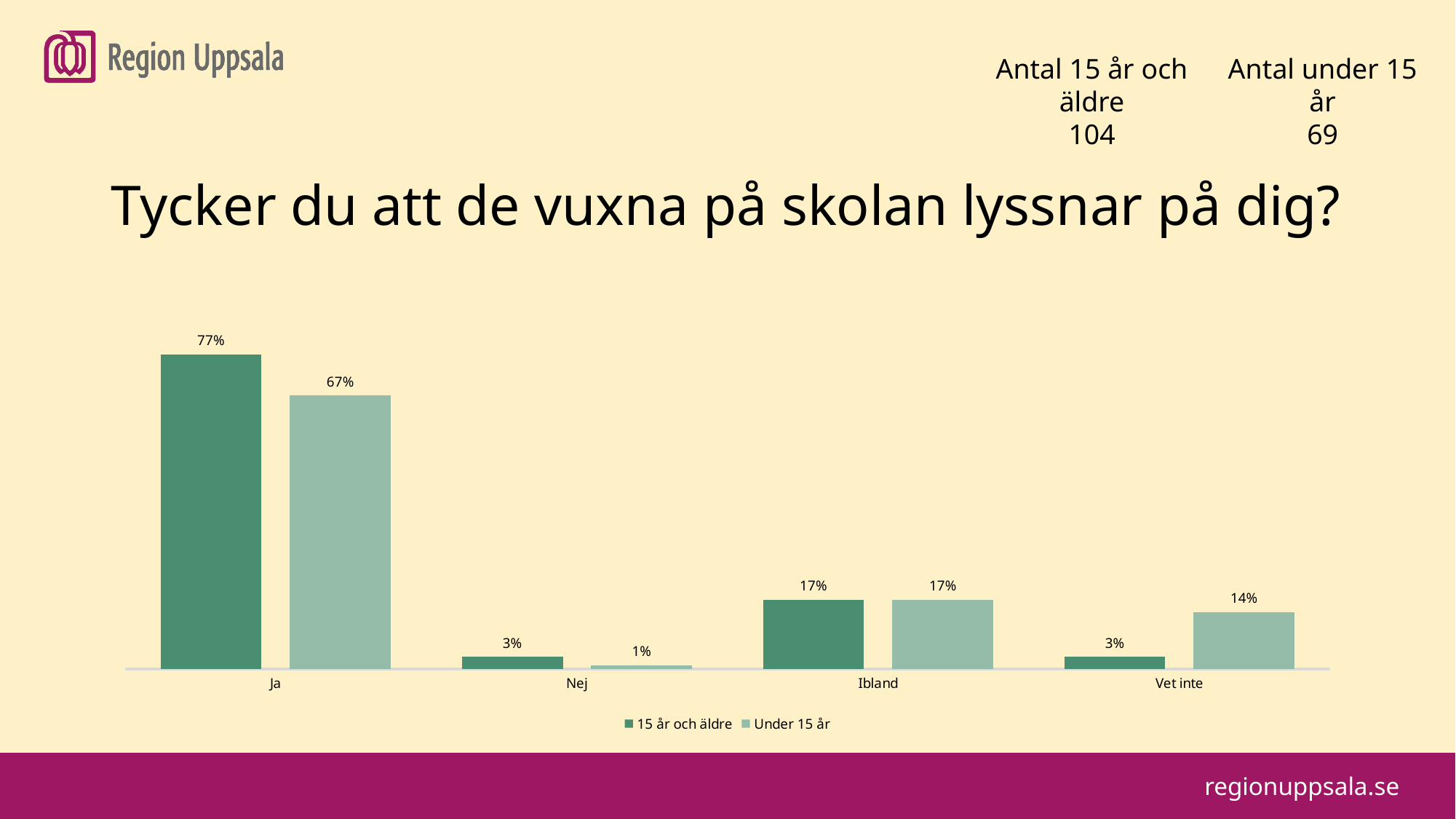
What is the title of the slide above the chart? Tycker du att de vuxna på skolan lyssnar på dig? What is the difference between the "15 år och äldre" and "Under 15 år" values in the "Ja" category? 10 percentage points What is the value for "15 år och äldre" in the "Ja" category? 77% How many categories are shown on the x axis? 4 What is the value for "Under 15 år" in the "Vet inte" category? 14% Which category has the highest value for the "15 år och äldre" series? Ja What is the value for "Under 15 år" in the "Ja" category? 67% In the "Vet inte" category, which series has the larger value? Under 15 år What is the value for "15 år och äldre" in the "Nej" category? 3% Which category has the lowest value for the "Under 15 år" series? Nej What kind of chart is shown on the slide? Bar chart How many series does the legend list? 2